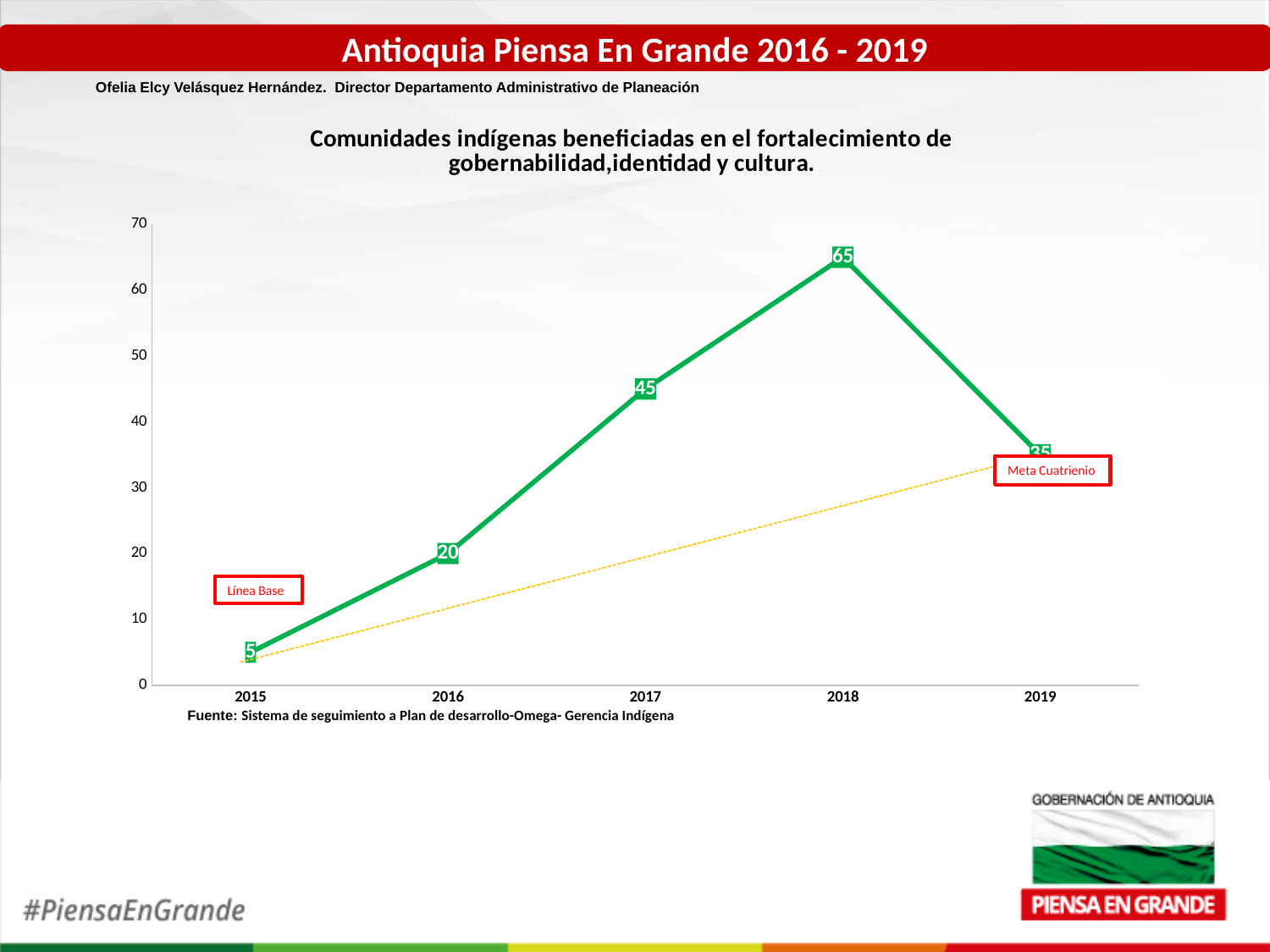
What is the difference between the values for 2018 and 2017? 20 Do the values rise or fall from 2015 to 2018? rise What kind of chart is shown on the slide? line chart Which year has the highest value? 2018 What is the value for 2015? 5 What is the value for 2017? 45 What is the value for 2018? 65 Is the value for 2019 greater or less than 30? greater Which is larger, the value for 2017 or the value for 2016? 2017 How many years are plotted on the x axis? 5 Which year has the lowest value? 2015 What is the value for 2016? 20